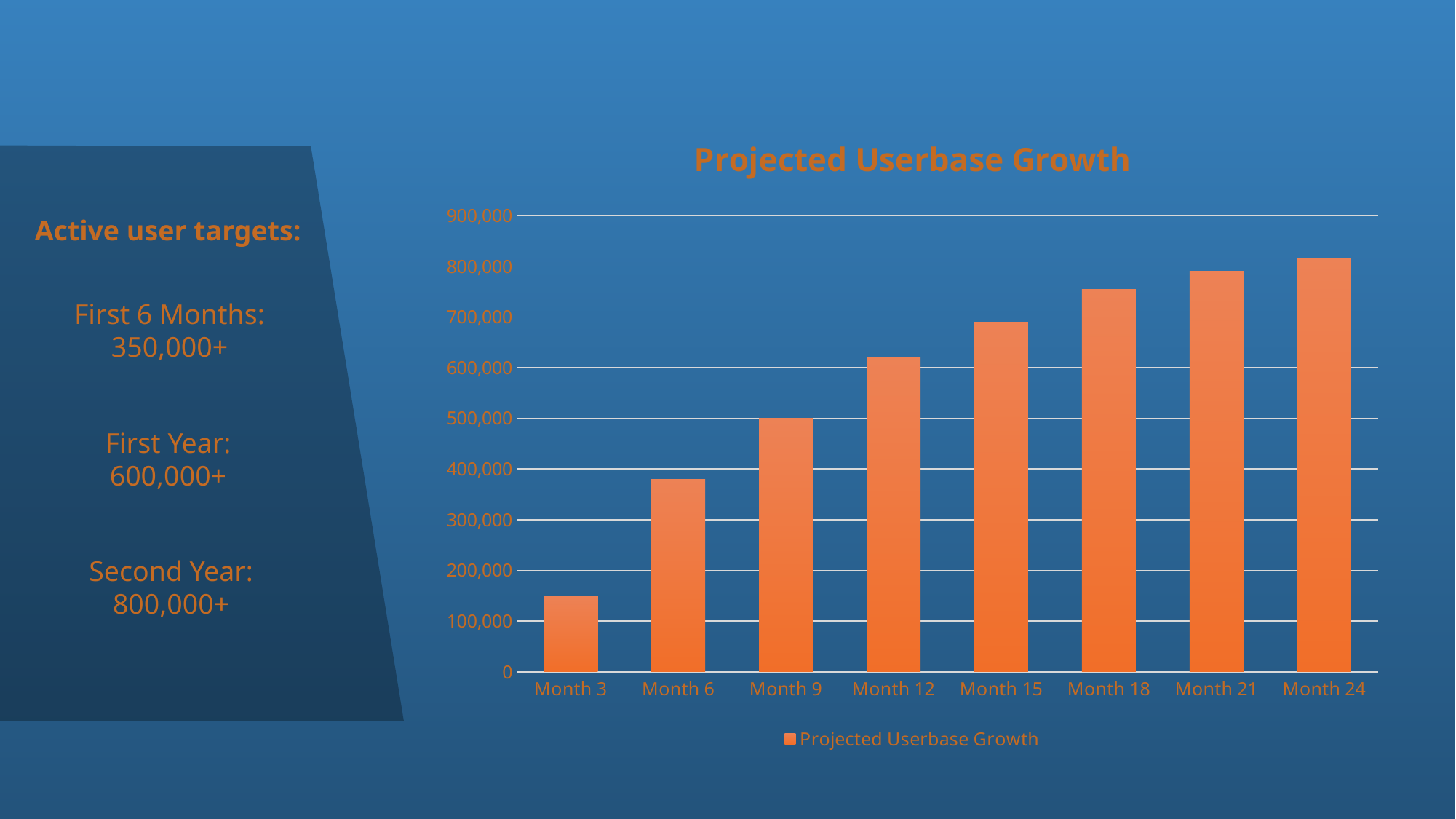
Is the value for Month 3 greater or less than 200,000? less Is the value for Month 15 greater or less than 600,000? greater What is the title of the chart? Projected Userbase Growth Which month has the lowest projected userbase? Month 3 What type of chart is shown on the slide? Bar chart Is the value for Month 6 greater or less than 300,000? greater Do the values rise or fall from Month 3 to Month 24? Rise How many series does the chart's legend list? 1 How many months (categories) are plotted on the x axis of the chart? 8 Which is larger, the value for Month 12 or the value for Month 6? Month 12 Which month has the highest projected userbase? Month 24